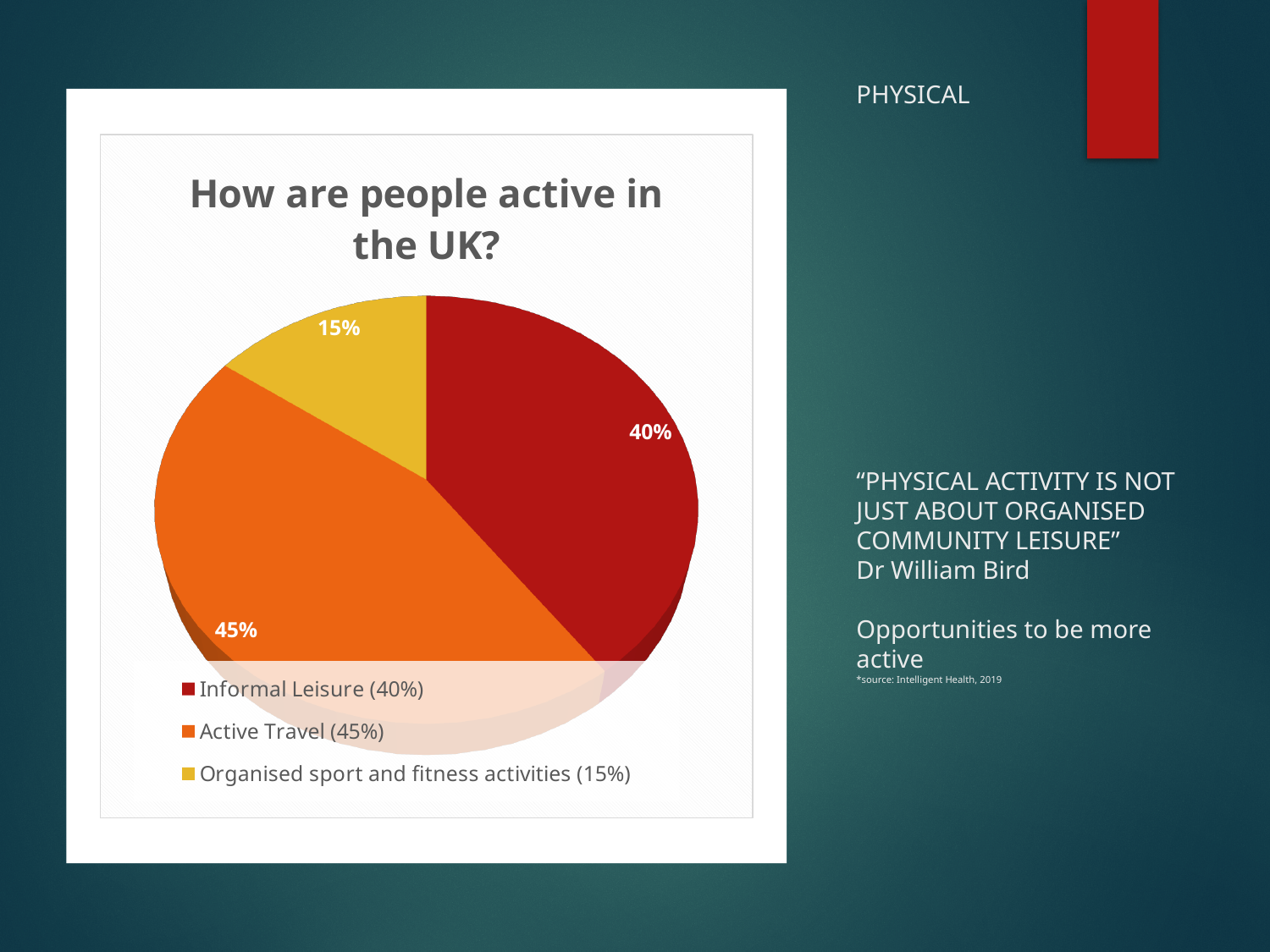
What percentage of the pie is Active Travel? 45% What colour is the Active Travel slice? orange What is the difference in percentage points between Active Travel and Informal Leisure? 5 What is the difference in percentage points between Informal Leisure and Organised sport and fitness activities? 25 What percentage of the pie is Informal Leisure? 40% Which is larger, the share for Informal Leisure or the share for Organised sport and fitness activities? Informal Leisure How many categories does the pie chart have? 3 What percentage of the pie is Organised sport and fitness activities? 15% Which category has the largest share of the pie? Active Travel What is the title of the chart? How are people active in the UK? What kind of chart is shown on the slide? pie chart Which category has the smallest share of the pie? Organised sport and fitness activities